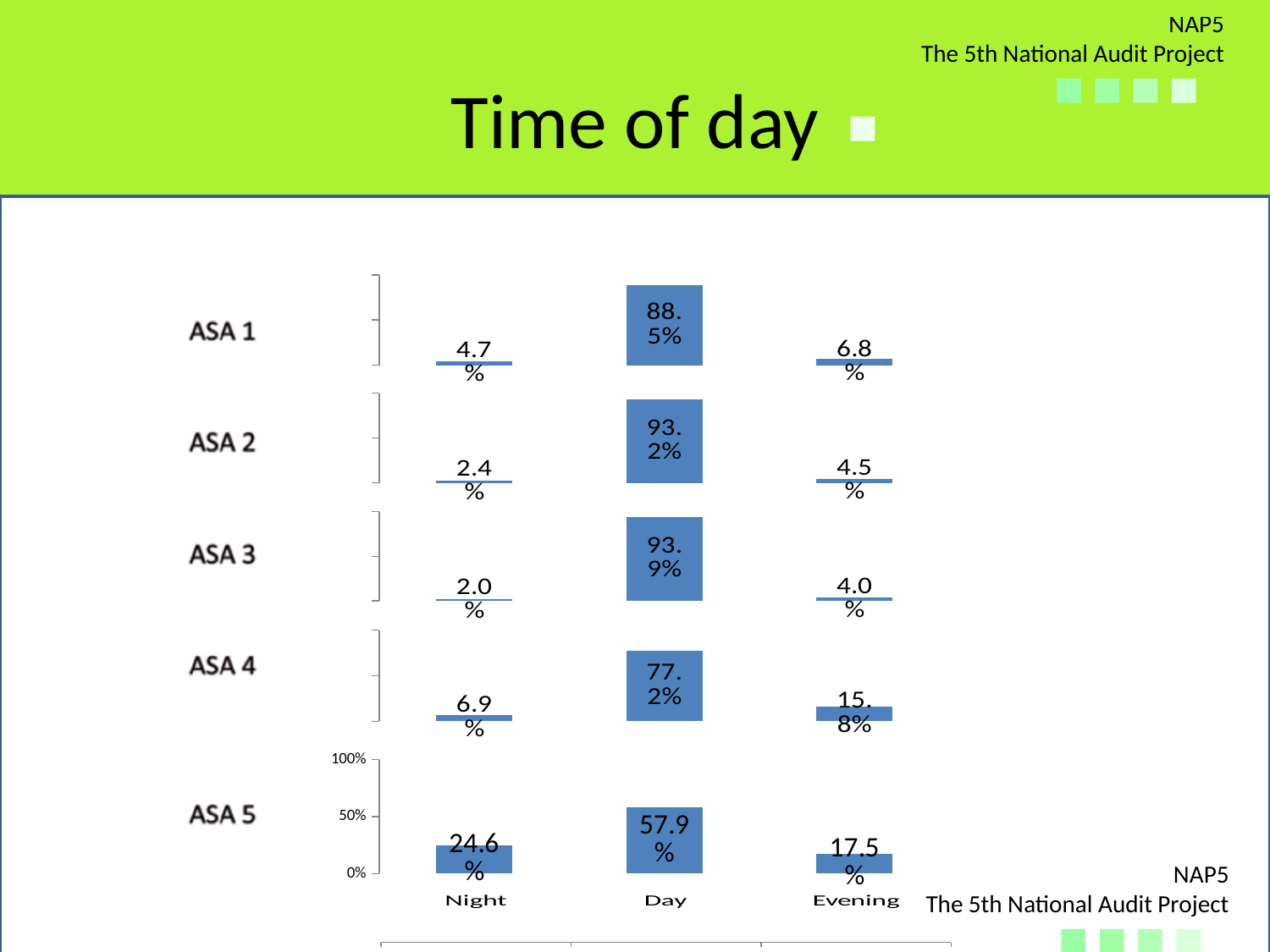
In the ASA 5 chart, is the value for Day greater or less than 50%? greater How many ASA charts are shown on the slide? 5 In the ASA 3 chart, which time of day has the highest value? Day In the ASA 1 chart, what is the value for Day? 88.5% In the ASA 4 chart, what is the value for Evening? 15.8% In the ASA 5 chart, which time of day has the lowest value? Evening How many time-of-day categories does each chart show? 3 In the ASA 2 chart, what is the value for Night? 2.4% In the ASA 1 chart, what is the difference between the Day value and the Evening value? 81.7% In the ASA 5 chart, what is the value for Night? 24.6% In the ASA 4 chart, which is larger, the Night value or the Evening value? Evening What kind of chart is used for each ASA row? Bar chart